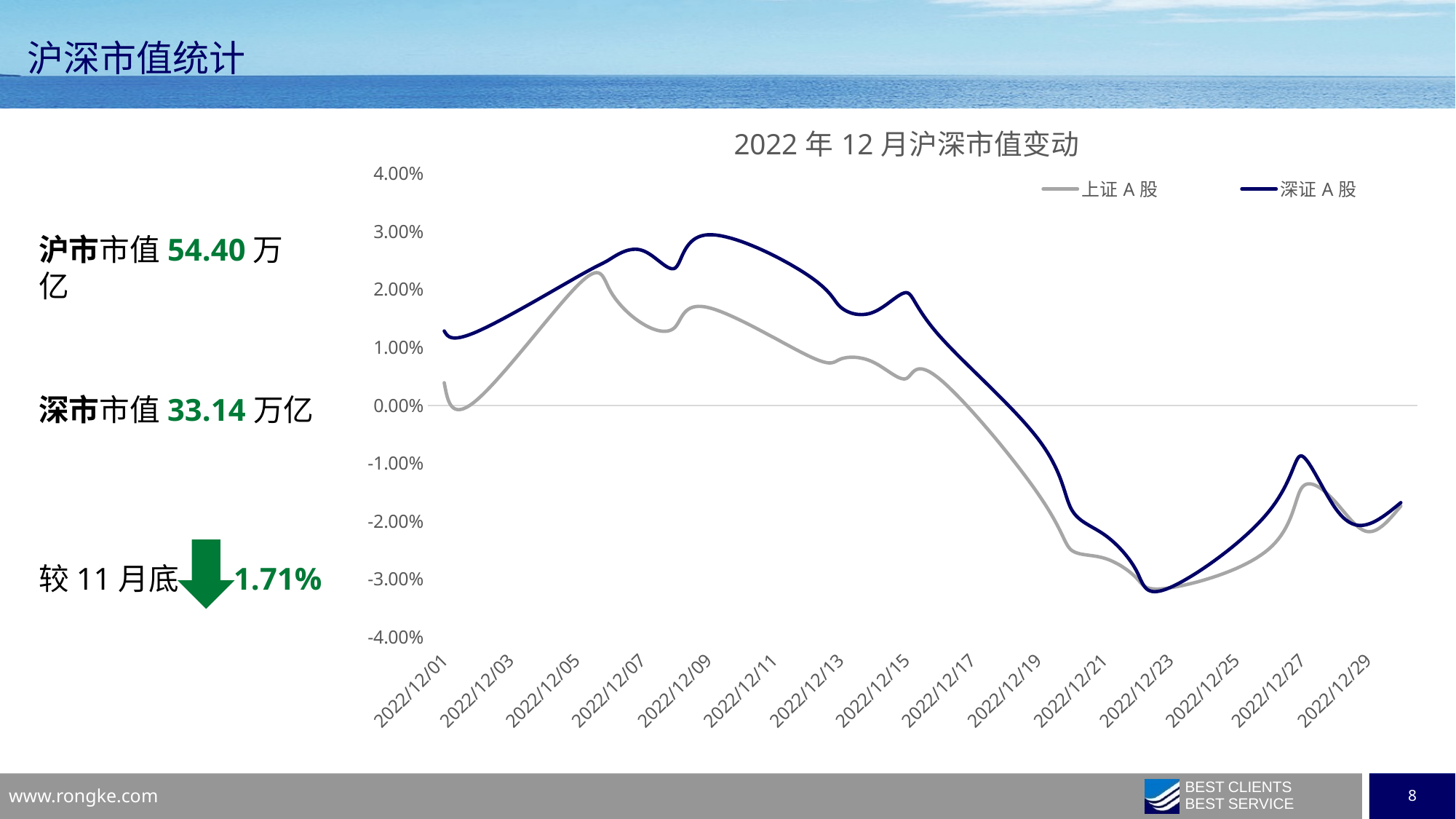
How many series does the chart legend list? 2 Is the value for 深证 A 股 on 2022/12/09 greater or less than 2.00%? greater Is the value for 上证 A 股 on 2022/12/21 greater or less than -2.00%? less Which series is drawn in dark blue in the chart? 深证 A 股 On 2022/12/09, which series has the higher value, 上证 A 股 or 深证 A 股? 深证 A 股 Between 2022/12/15 and 2022/12/23, does the 深证 A 股 line rise or fall? fall Is the value for 深证 A 股 on 2022/12/05 greater or less than 1.00%? greater On 2022/12/27, which series has the higher value, 上证 A 股 or 深证 A 股? 深证 A 股 What kind of chart is shown on the slide? line chart Which series reaches the highest value anywhere in the chart? 深证 A 股 What is the title of the chart? 2022 年 12 月沪深市值变动